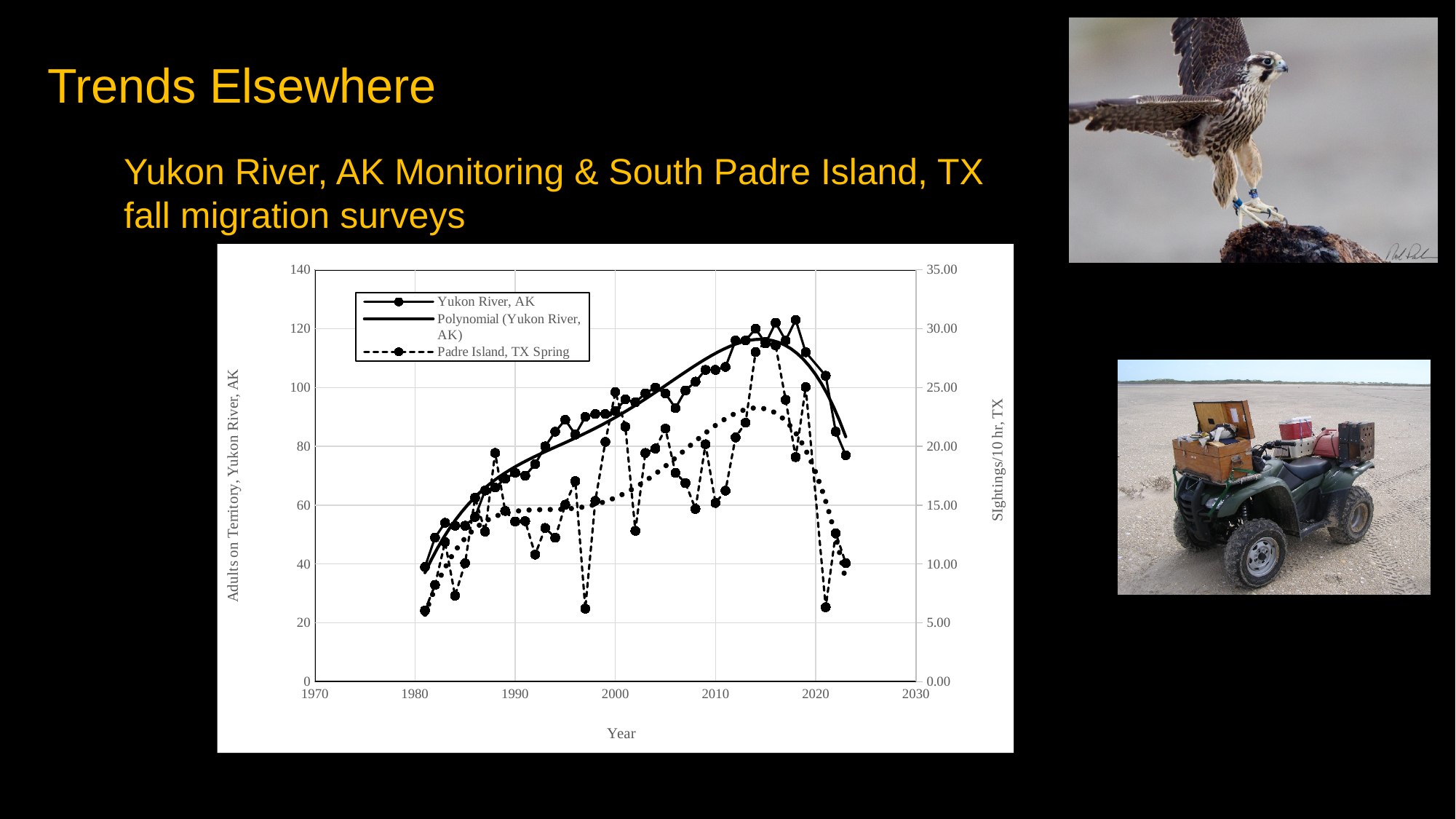
What is the title of the left y axis of the chart? Adults on Territory, Yukon River, AK Is the Yukon River, AK value for 2010 greater or less than 100? greater Is the Padre Island, TX Spring value for 2021 greater or less than 10.00? less Does the Padre Island, TX Spring series rise or fall between 2015 and 2021? fall Is the Yukon River, AK value for 1990 greater or less than 80? less How many entries does the chart's legend list? 3 What is the title of the x axis of the chart? Year Does the Yukon River, AK series generally rise or fall between 1981 and 2015? rise What kind of chart is shown on the slide? line chart Which is larger for the Yukon River, AK series: the value for 1990 or the value for 2010? 2010